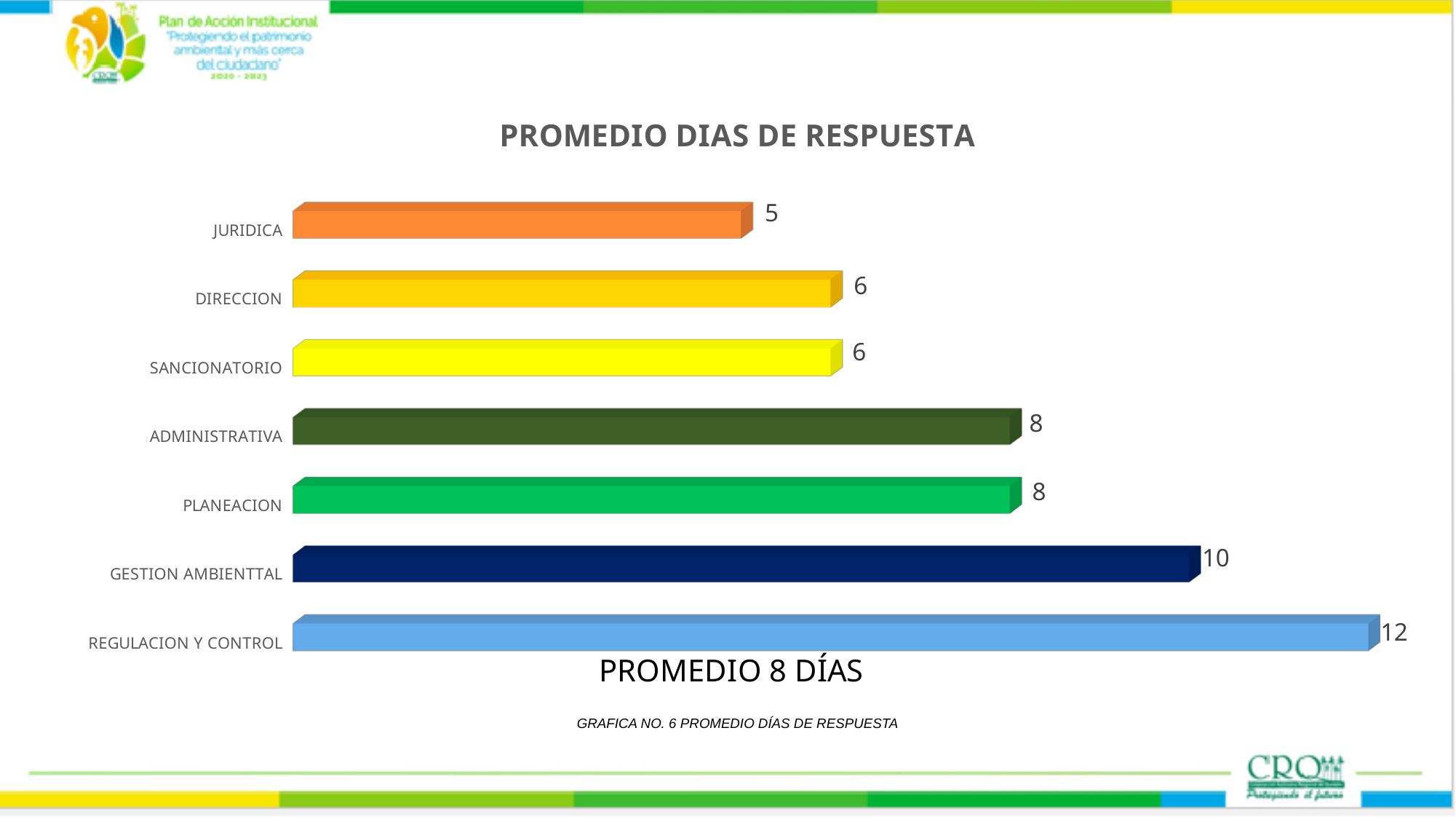
What is the value for JURIDICA? 5 Which category has the highest value? REGULACION Y CONTROL What is the title of the chart? PROMEDIO DIAS DE RESPUESTA What is the difference between the values for REGULACION Y CONTROL and JURIDICA? 7 Which category has the lowest value? JURIDICA What colour is the bar for REGULACION Y CONTROL? Light blue What kind of chart is shown on the slide? Bar chart What is the value for ADMINISTRATIVA? 8 What is the value for GESTION AMBIENTTAL? 10 Which is larger, the value for DIRECCION or the value for ADMINISTRATIVA? ADMINISTRATIVA What is the difference between the values for GESTION AMBIENTTAL and PLANEACION? 2 How many categories are shown in the chart? 7